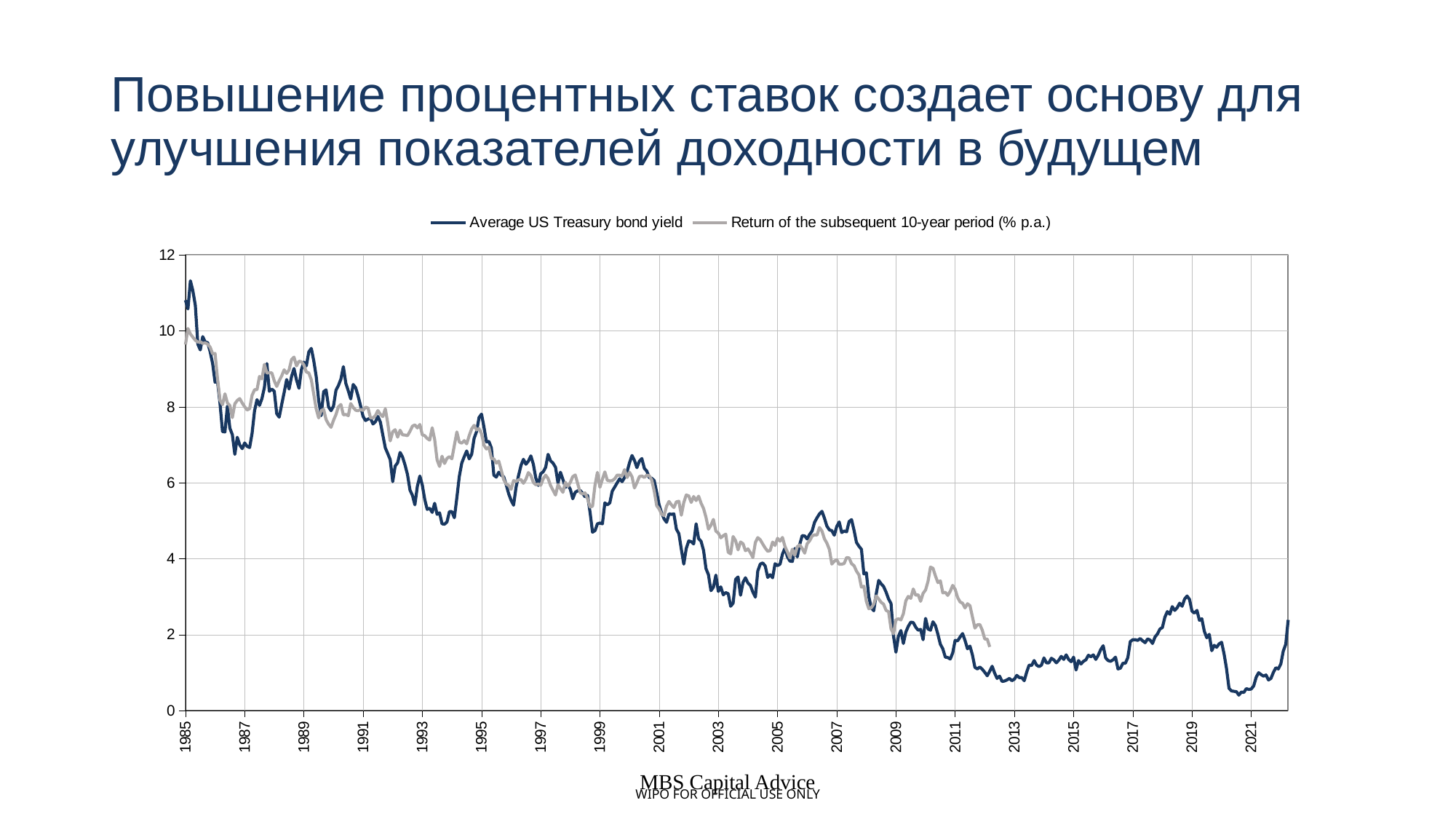
Does the Average US Treasury bond yield rise or fall overall from 1985 to 2021? fall Which series extends further to the right along the x axis? Average US Treasury bond yield Does the Return of the subsequent 10-year period (% p.a.) rise or fall overall from 1985 to its last plotted point? fall Is the Average US Treasury bond yield in 2007 greater or less than 4? greater What are the two series named in the legend? Average US Treasury bond yield; Return of the subsequent 10-year period (% p.a.) What kind of chart is shown on the slide? line chart How many series does the legend list? 2 Is the last plotted value of the Return of the subsequent 10-year period (% p.a.) series greater or less than 4? less Is the Average US Treasury bond yield in 2019 greater or less than 4? less